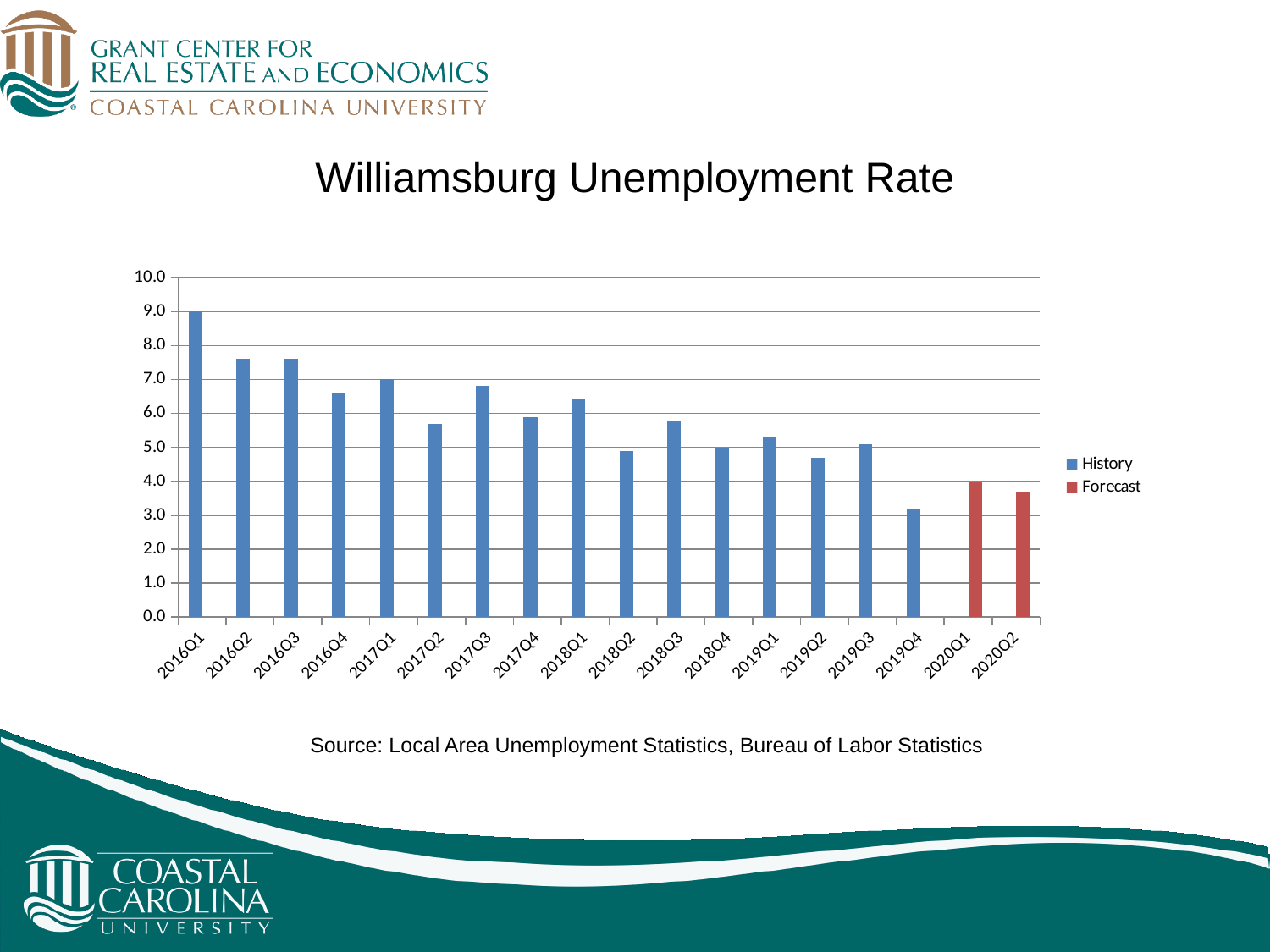
What type of chart is shown on the slide? bar chart Is the value for 2020Q2 greater or less than 4.0? less Which is larger, the value for 2017Q3 or the value for 2017Q4? 2017Q3 Which quarter has the lowest unemployment rate? 2019Q4 How many quarters are shown on the x axis? 18 Do the unemployment rates generally rise or fall from 2016Q1 to 2020Q2? fall Which quarter has the highest unemployment rate? 2016Q1 What is the unemployment rate for 2016Q1? 9.0 How many series does the legend list? 2 What is the title of the chart? Williamsburg Unemployment Rate What is the unemployment rate for 2020Q1? 4.0 Is the value for 2016Q2 greater or less than 7.0? greater